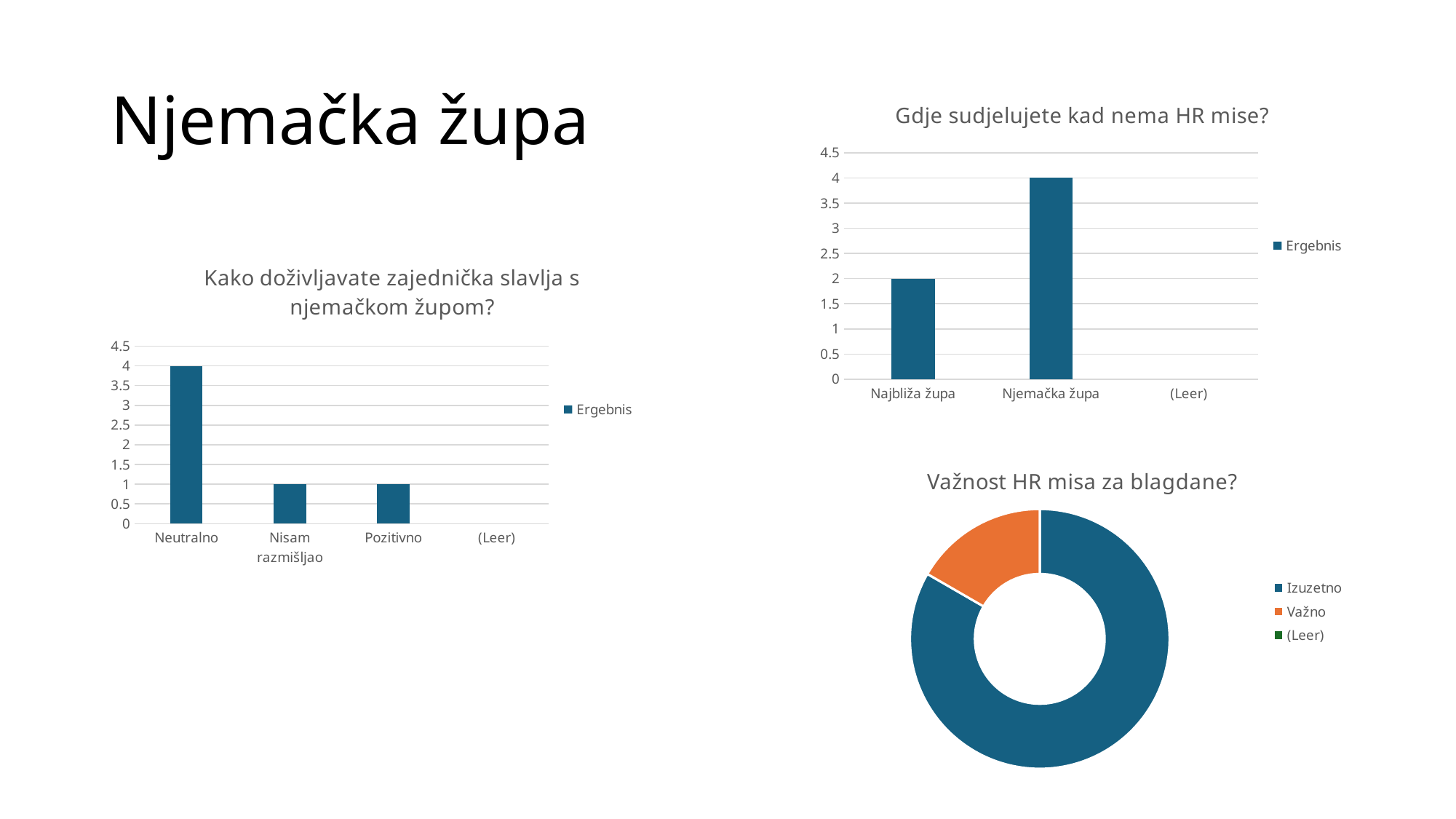
How many entries does the legend of the chart 'Važnost HR misa za blagdane?' list? 3 In the chart 'Kako doživljavate zajednička slavlja s njemačkom župom?', what is the difference between Neutralno and Nisam razmišljao? 3 In the chart 'Gdje sudjelujete kad nema HR mise?', which is larger, Najbliža župa or Njemačka župa? Njemačka župa In the chart 'Gdje sudjelujete kad nema HR mise?', what is the value for Njemačka župa? 4 In the chart 'Gdje sudjelujete kad nema HR mise?', what is the difference between Njemačka župa and Najbliža župa? 2 What kind of chart is 'Važnost HR misa za blagdane?'? Doughnut chart In the chart 'Kako doživljavate zajednička slavlja s njemačkom župom?', what is the value for Pozitivno? 1 In the chart 'Gdje sudjelujete kad nema HR mise?', what is the value for Najbliža župa? 2 In the chart 'Kako doživljavate zajednička slavlja s njemačkom župom?', which category has the highest value? Neutralno In the chart 'Kako doživljavate zajednička slavlja s njemačkom župom?', what is the value for Neutralno? 4 In the chart 'Važnost HR misa za blagdane?', which category has the largest share? Izuzetno How many categories are shown on the x axis of the chart 'Kako doživljavate zajednička slavlja s njemačkom župom?'? 4